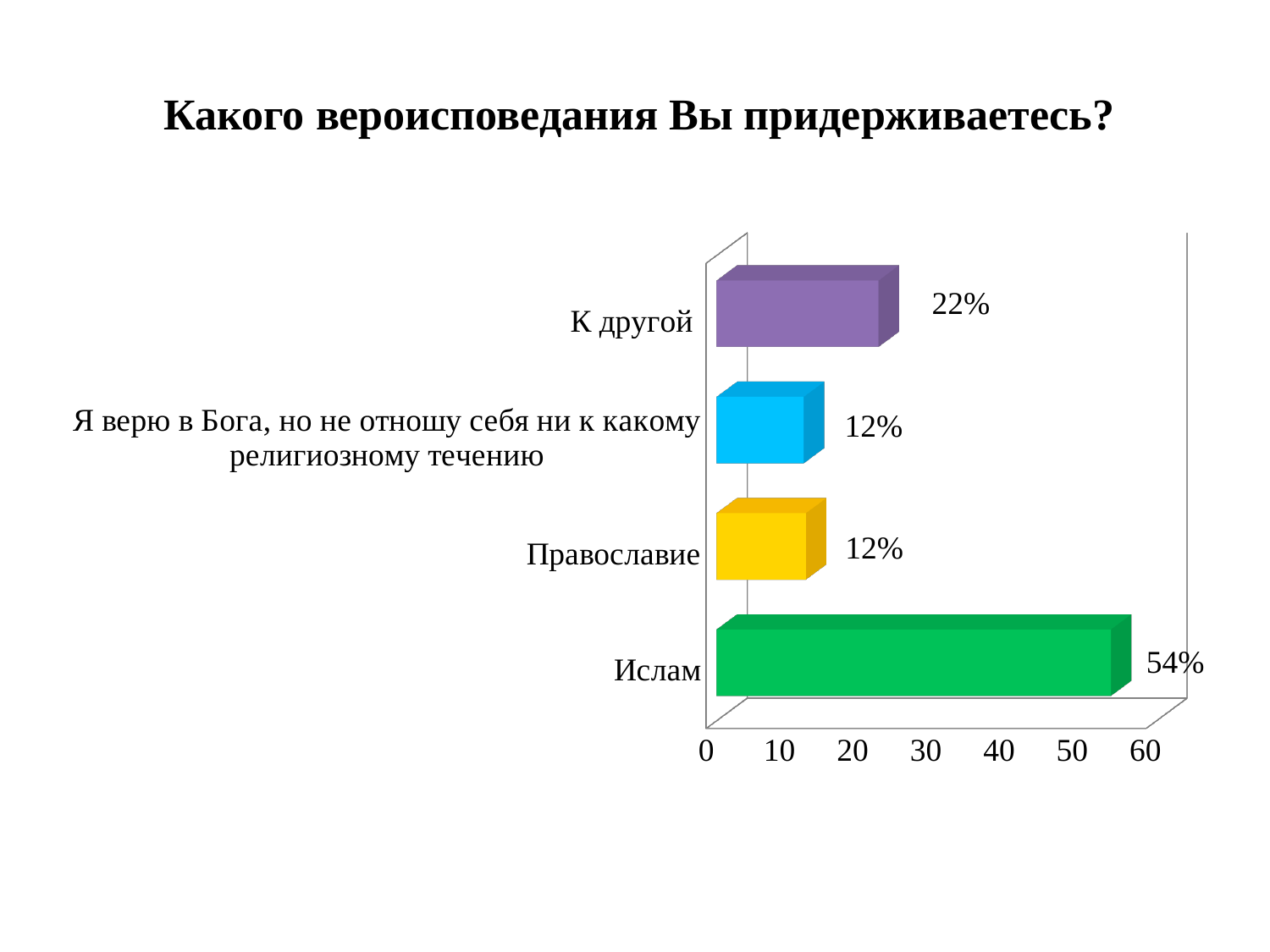
What is the value for Православие? 12% What is the value for Ислам? 54% How many categories are shown in the chart? 4 Is the value for Ислам greater or less than 50? greater What kind of chart is shown on the slide? bar chart What is the value for К другой? 22% Is the value for К другой greater or less than 30? less What is the difference between the values for Ислам and К другой? 32% Which category has the highest value? Ислам What is the title of the chart? Какого вероисповедания Вы придерживаетесь? What colour is the bar for Ислам? green Which is larger, the value for К другой or the value for Православие? К другой